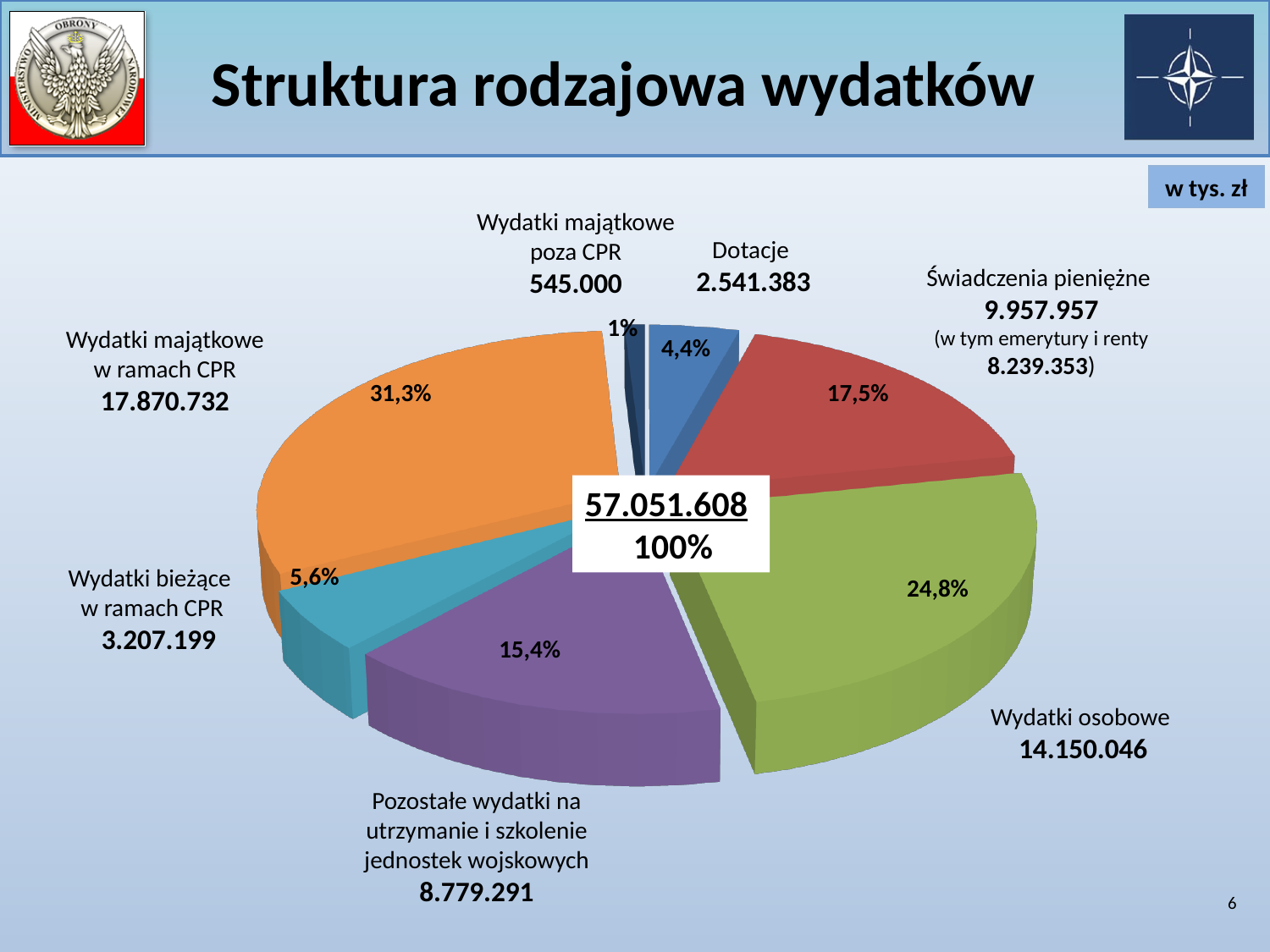
What share of the pie does Wydatki majątkowe w ramach CPR represent? 31,3% Which category has the smallest share of the pie? Wydatki majątkowe poza CPR What kind of chart is shown on the slide? pie chart What percentage is shown for Dotacje? 4,4% Which is larger, the value for Wydatki osobowe or the value for Świadczenia pieniężne? Wydatki osobowe How many slices does the pie chart have? 7 What is the total value shown in the centre of the pie chart? 57.051.608 Which category has the largest share of the pie? Wydatki majątkowe w ramach CPR What is the difference between the percentage shares of Wydatki osobowe and Pozostałe wydatki na utrzymanie i szkolenie jednostek wojskowych? 9,4% What is the value shown for Wydatki osobowe? 14.150.046 What is the title of the slide containing the pie chart? Struktura rodzajowa wydatków What is the value shown for Świadczenia pieniężne? 9.957.957